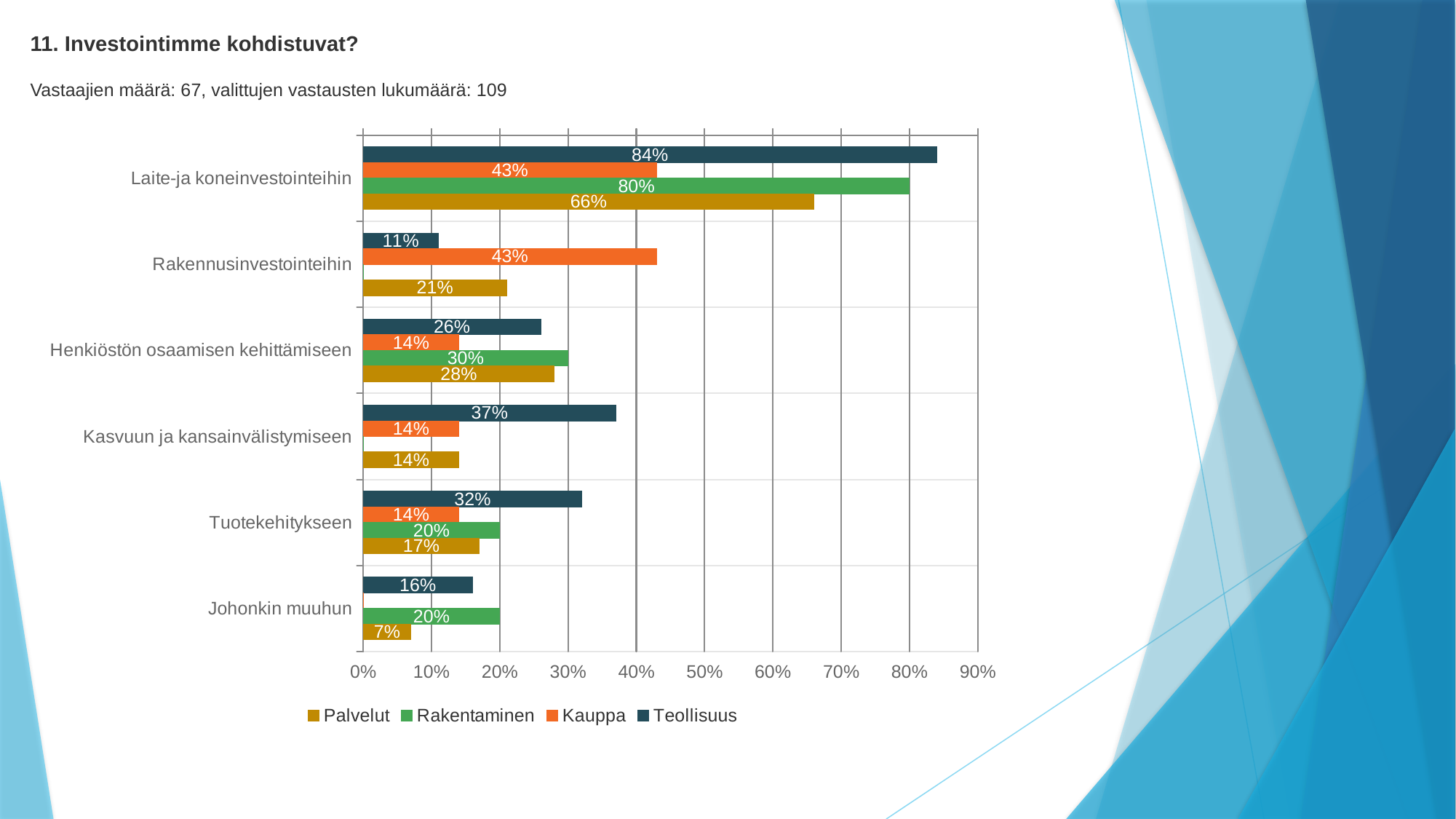
What is the value for Teollisuus in the category Kasvuun ja kansainvälistymiseen? 37% What is the difference between the Teollisuus and Kauppa values in the category Laite-ja koneinvestointeihin? 41% What is the value for Teollisuus in the category Laite-ja koneinvestointeihin? 84% What is the value for Palvelut in the category Rakennusinvestointeihin? 21% In the category Tuotekehitykseen, which is larger: the value for Teollisuus or the value for Rakentaminen? Teollisuus Which category has the lowest value for Palvelut? Johonkin muuhun What is the value for Rakentaminen in the category Henkiöstön osaamisen kehittämiseen? 30% What is the title of the chart on the slide? 11. Investointimme kohdistuvat? How many categories are shown on the vertical axis of the chart? 6 What kind of chart is shown on the slide? bar chart Which category has the highest value for Kauppa? Laite-ja koneinvestointeihin and Rakennusinvestointeihin (both 43%) How many series does the legend list? 4